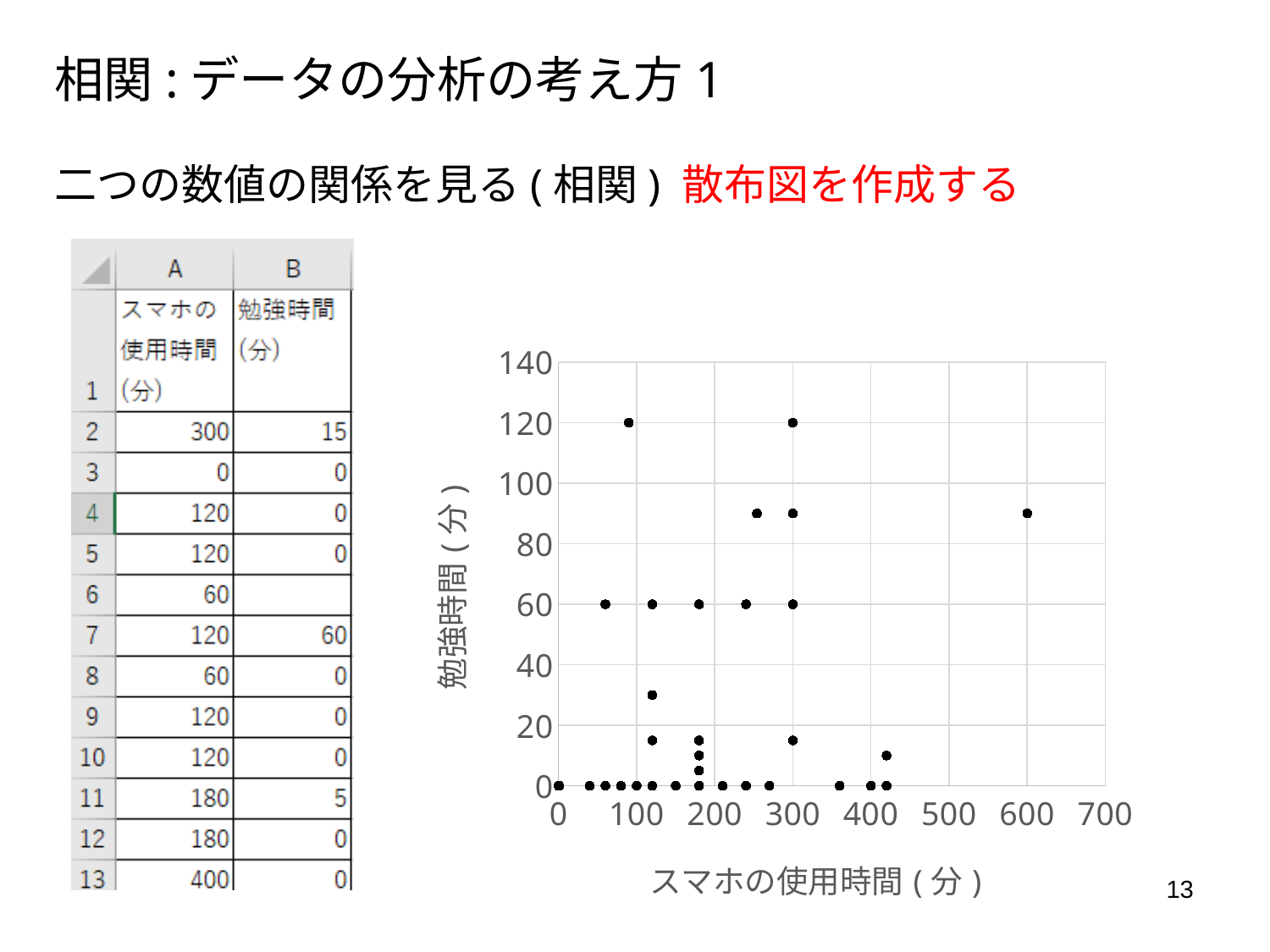
What is the title of the vertical axis of the scatter chart? 勉強時間(分) What is the highest 勉強時間 value reached by any point in the scatter chart? 120 Is the largest スマホの使用時間 value plotted in the scatter chart greater or less than 500? greater What is the title of the horizontal axis of the scatter chart? スマホの使用時間(分) What kind of chart is shown on the slide? scatter chart Is the 勉強時間 of the point at スマホの使用時間 400 greater or less than 20? less How many points in the scatter chart have a 勉強時間 of 120? 2 What is the 勉強時間 of the highest point at スマホの使用時間 300? 120 What is the lowest 勉強時間 value reached by any point in the scatter chart? 0 Is the 勉強時間 of the rightmost point (around 600 minutes of smartphone use) greater or less than 80? greater Which has the higher 勉強時間: the point at スマホの使用時間 300 with the highest study time, or the point at スマホの使用時間 600? the point at 300